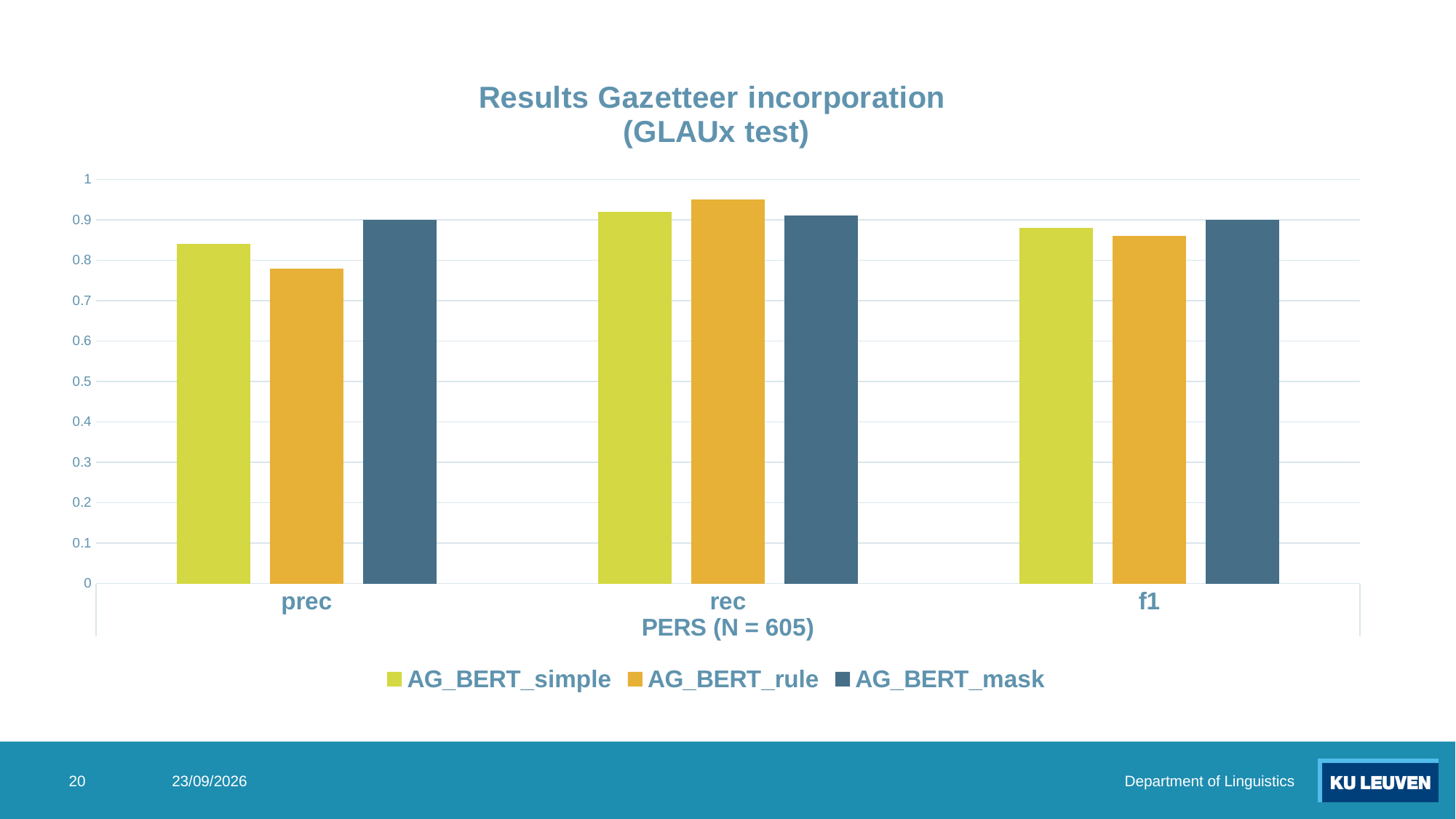
What kind of chart is shown on the slide? bar chart Is the value of AG_BERT_simple for prec greater or less than 0.8? greater Which series has the highest value for prec? AG_BERT_mask Is the value of AG_BERT_rule for rec greater or less than 0.9? greater What is the value of AG_BERT_mask for f1? 0.9 How many categories are shown on the x axis? 3 Which series has the lowest value for prec? AG_BERT_rule How many series does the legend list? 3 Which series has the highest value for rec? AG_BERT_rule What is the value of AG_BERT_mask for prec? 0.9 Which is larger: AG_BERT_rule for rec or AG_BERT_rule for prec? AG_BERT_rule for rec Is the value of AG_BERT_rule for prec greater or less than 0.8? less